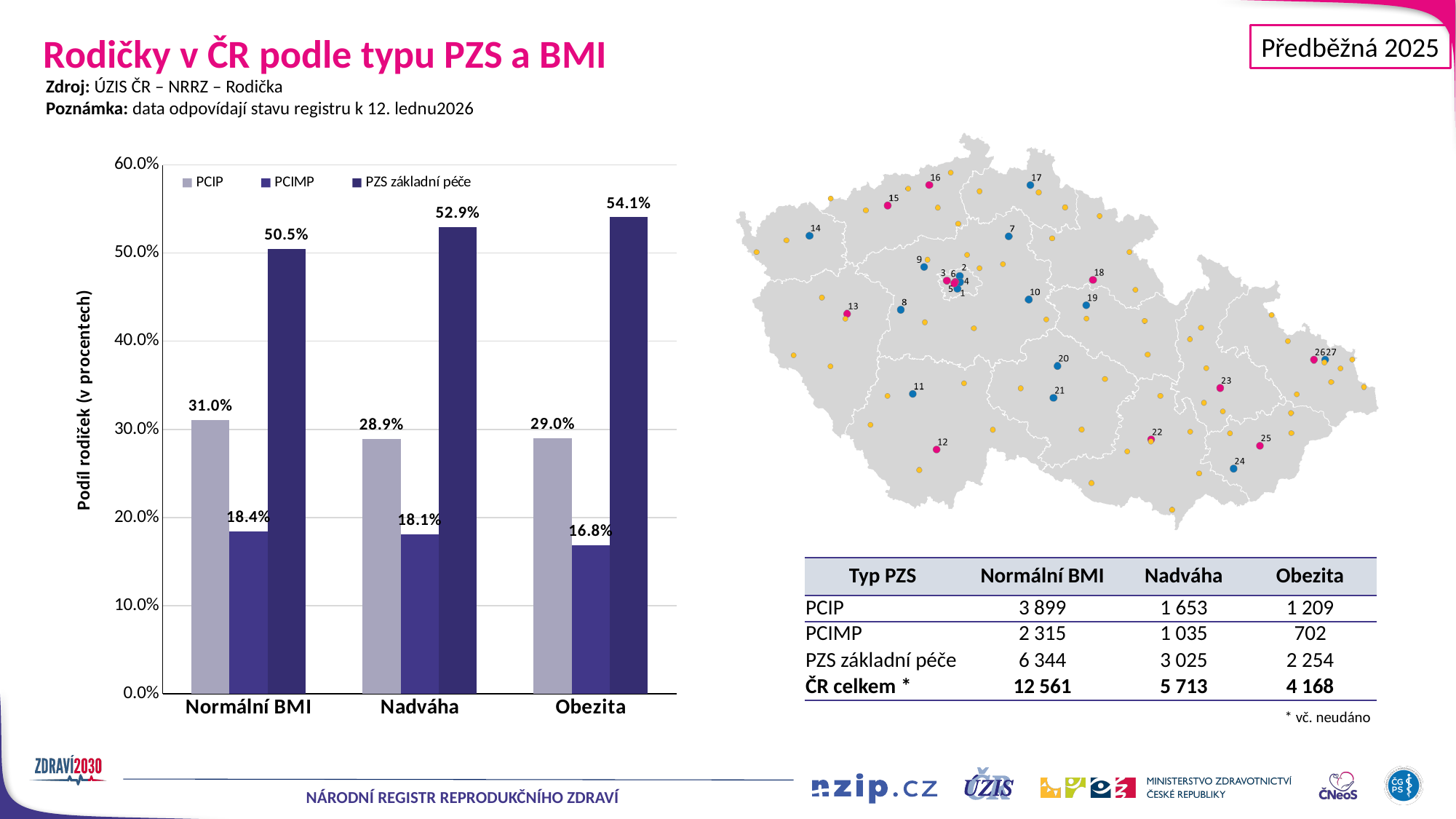
What is the value for PCIMP in the Nadváha category? 18.1% What is the value for PZS základní péče in the Obezita category? 54.1% Which category has the lowest value for PCIMP? Obezita Which category has the highest value for PZS základní péče? Obezita What is the value for PCIP in the Normální BMI category? 31.0% What is the difference between the PCIMP values for Normální BMI and Obezita? 1.6% What is the difference between the PZS základní péče value and the PCIP value in the Normální BMI category? 19.5% Do the PZS základní péče values rise or fall from Normální BMI to Obezita? rise What kind of chart is shown on the left of the slide? bar chart How many series does the legend of the bar chart list? 3 Which is larger in the Nadváha category: the PCIP value or the PCIMP value? PCIP How many categories are shown on the x axis of the bar chart? 3